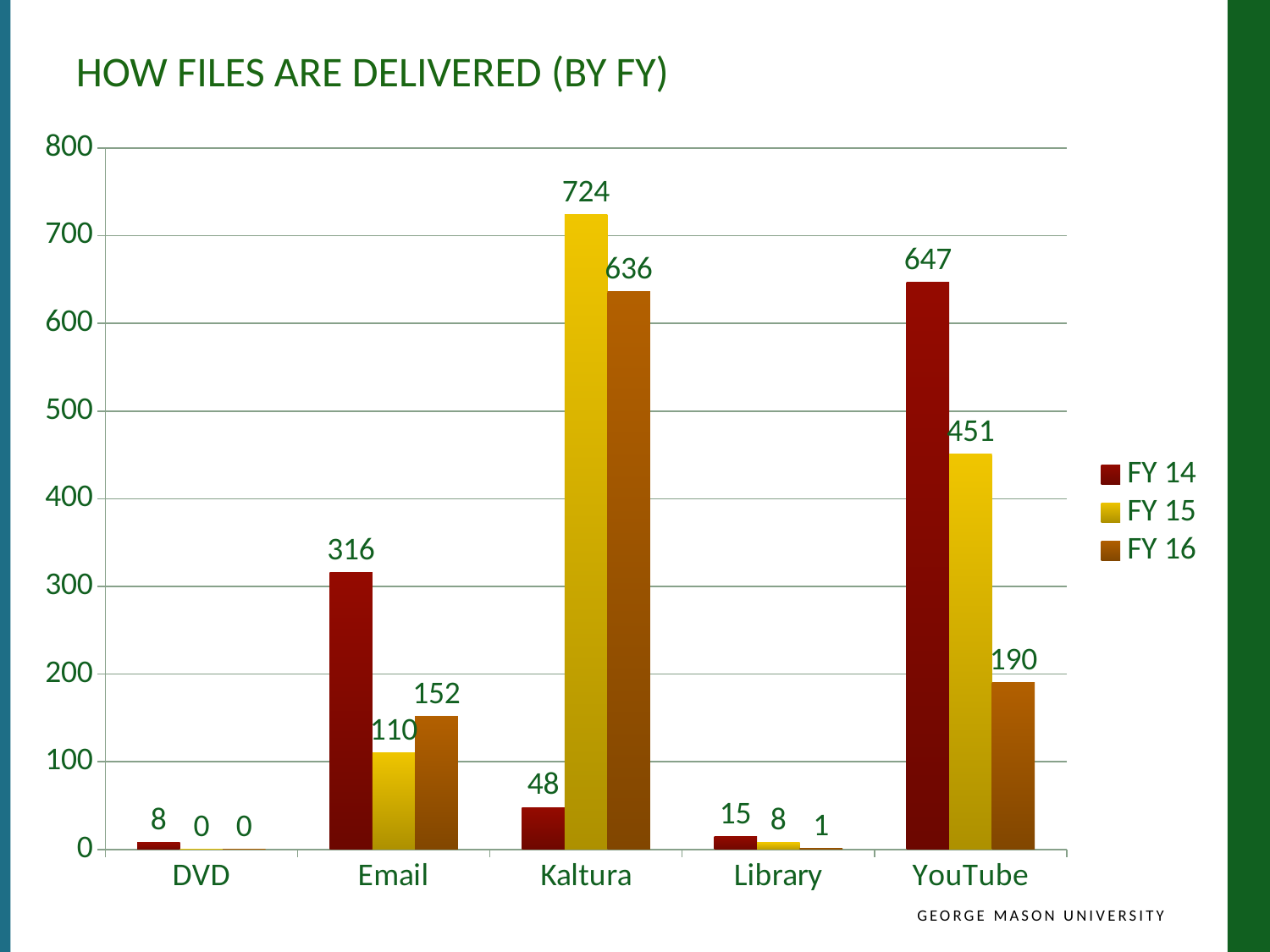
What is the FY 15 value for Library? 8 What is the title of the chart? HOW FILES ARE DELIVERED (BY FY) What kind of chart is shown on the slide? Bar chart Which category has the lowest FY 16 value? DVD What is the difference between the FY 15 and FY 16 values for Kaltura? 88 Which is larger for YouTube, the FY 15 value or the FY 16 value? FY 15 What is the FY 16 value for Email? 152 How many series does the legend list? 3 What is the FY 15 value for Kaltura? 724 How many categories are shown on the x axis? 5 What is the FY 14 value for YouTube? 647 Which category has the highest FY 14 value? YouTube